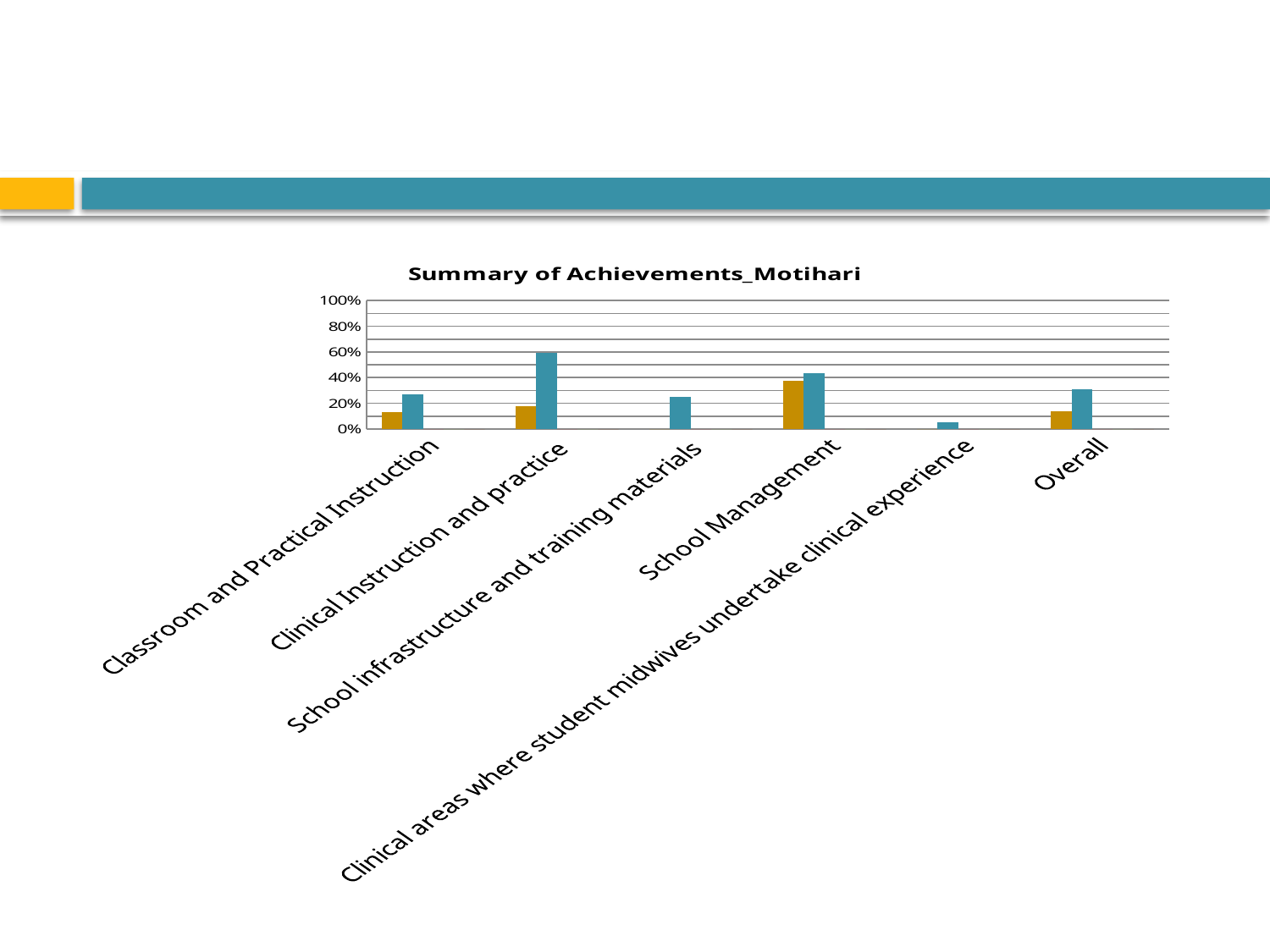
Which is larger: the blue bar for Clinical Instruction and practice or the blue bar for Overall? Clinical Instruction and practice Which category has the tallest blue bar? Clinical Instruction and practice Which category has the shortest blue bar? Clinical areas where student midwives undertake clinical experience Which category has the tallest orange bar? School Management Is the blue bar for Clinical areas where student midwives undertake clinical experience greater or less than 20%? less Which is larger: the orange bar for School Management or the orange bar for Classroom and Practical Instruction? School Management Is the blue bar for Overall greater or less than 20%? greater How many categories are shown on the x axis of the chart? 6 Is the blue bar for Clinical Instruction and practice greater or less than 40%? greater What is the title of the chart? Summary of Achievements_Motihari What type of chart is shown on the slide? Bar chart